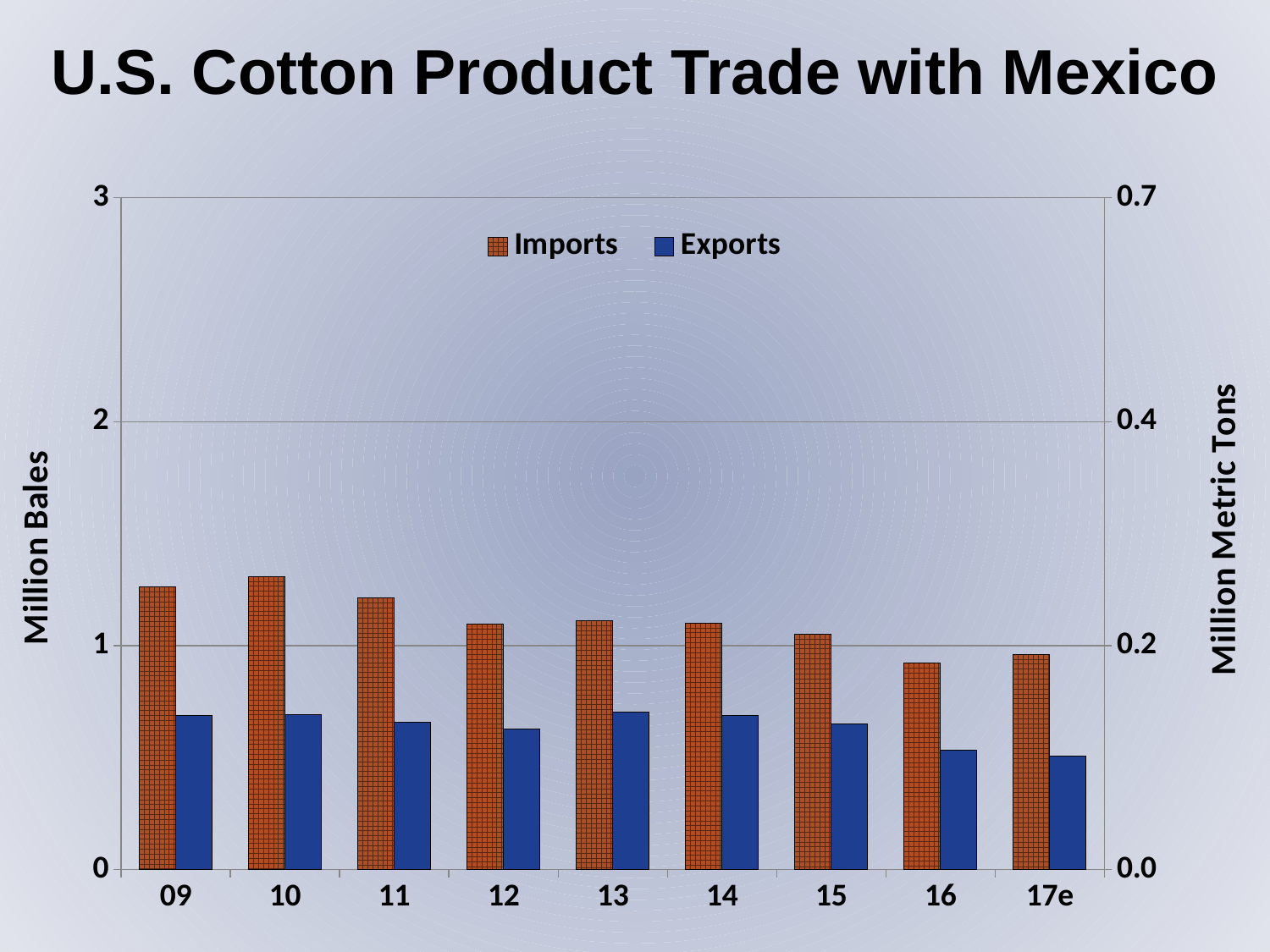
What is the label on the left vertical axis? Million Bales Is the Imports value for 09 greater or less than 1? greater Is the Imports value for 10 greater or less than 2? less What is the title of the chart? U.S. Cotton Product Trade with Mexico How many years (categories) are shown on the x axis? 9 Which year has the highest Imports value? 10 What kind of chart is shown on the slide? bar chart Is the Exports value for 13 greater or less than 1? less In 12, which is larger, Imports or Exports? Imports How many series does the legend list? 2 Do the Imports values generally rise or fall from 09 to 17e? fall